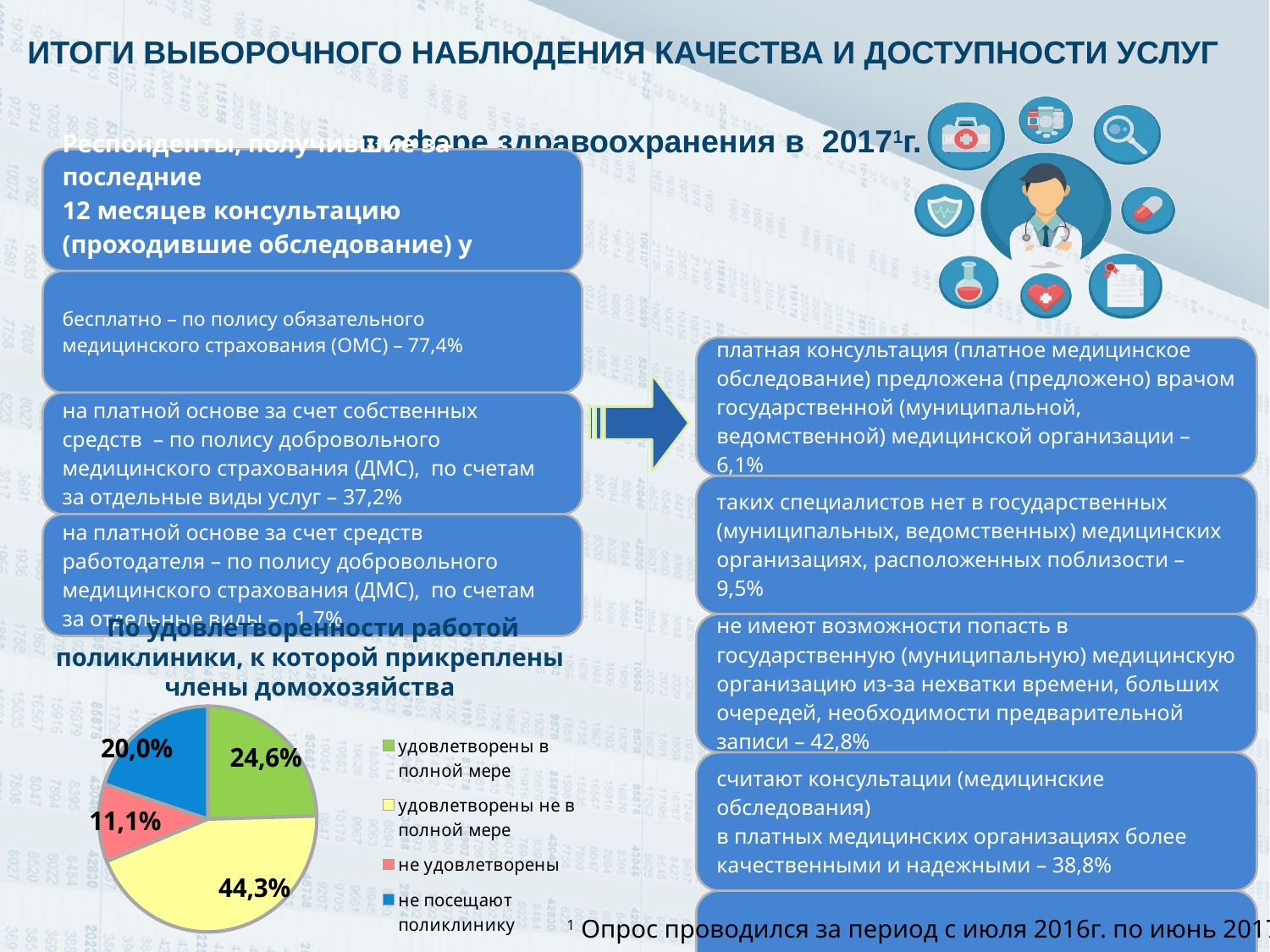
What share of the pie chart is labelled "удовлетворены не в полной мере"? 44,3% What share of the pie chart is labelled "удовлетворены в полной мере"? 24,6% How many slices does the pie chart have? 4 Which category has the largest slice in the pie chart? удовлетворены не в полной мере What is the title of the pie chart? По удовлетворенности работой поликлиники, к которой прикреплены члены домохозяйства What kind of chart is shown on the slide? pie chart What share of the pie chart is labelled "не посещают поликлинику"? 20,0% What colour is the slice for "не посещают поликлинику" in the pie chart? blue Which category has the smallest slice in the pie chart? не удовлетворены What share of the pie chart is labelled "не удовлетворены"? 11,1% What is the difference between the shares for "удовлетворены не в полной мере" and "удовлетворены в полной мере"? 19,7% Which is larger: the share for "не посещают поликлинику" or the share for "не удовлетворены"? не посещают поликлинику